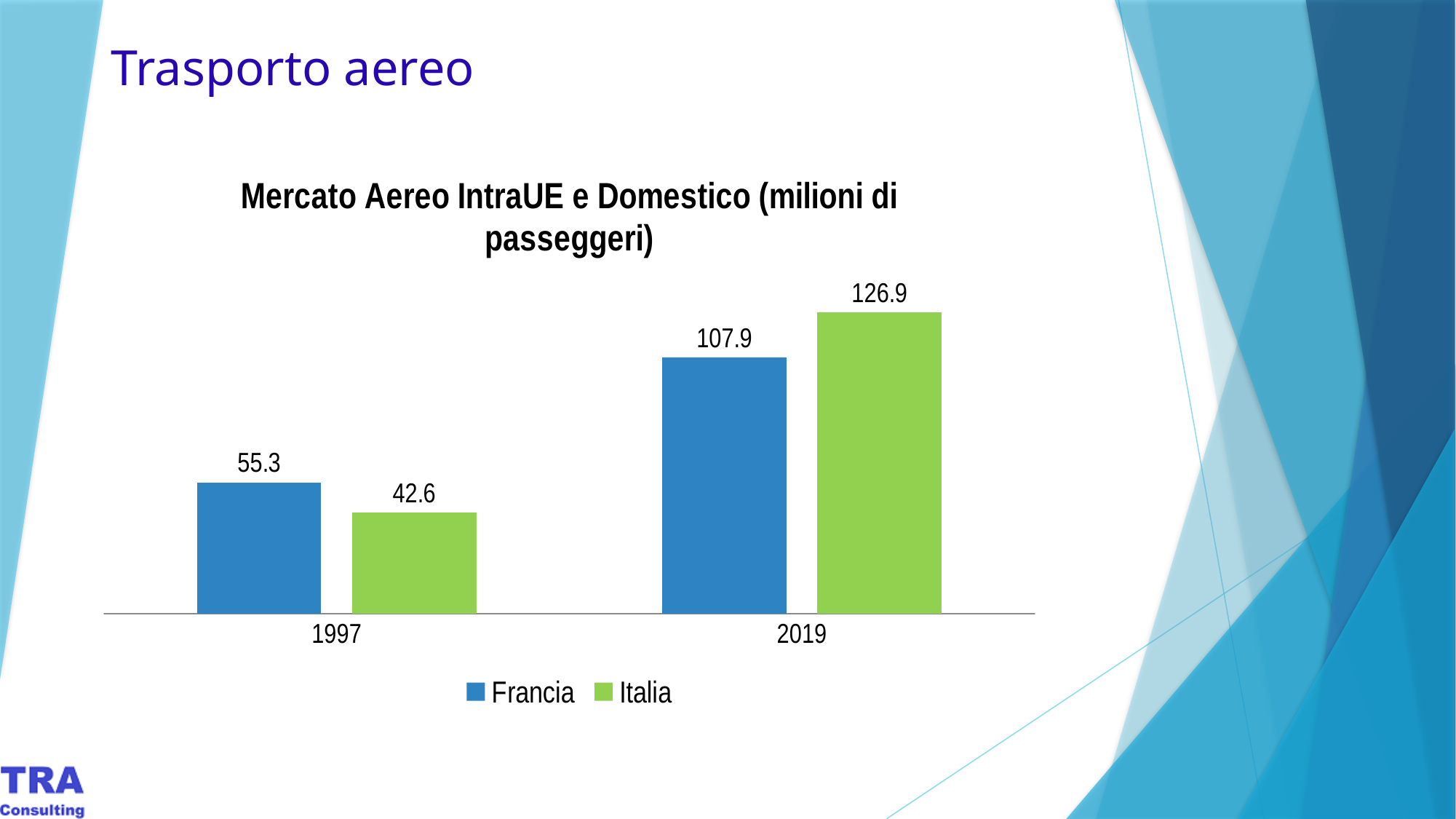
Does the value for Italia rise or fall from 1997 to 2019? Rise Which series has the highest value in 2019? Italia Which bar has the lowest value in the chart? Italia in 1997 What is the value for Italia in 2019? 126.9 Which is larger in 1997, Francia or Italia? Francia What is the value for Italia in 1997? 42.6 What is the difference between the Francia and Italia values in 1997? 12.7 What kind of chart is shown? Bar chart What is the difference between the Italia and Francia values in 2019? 19 What is the value for Francia in 2019? 107.9 What is the value for Francia in 1997? 55.3 How many series does the legend list? 2